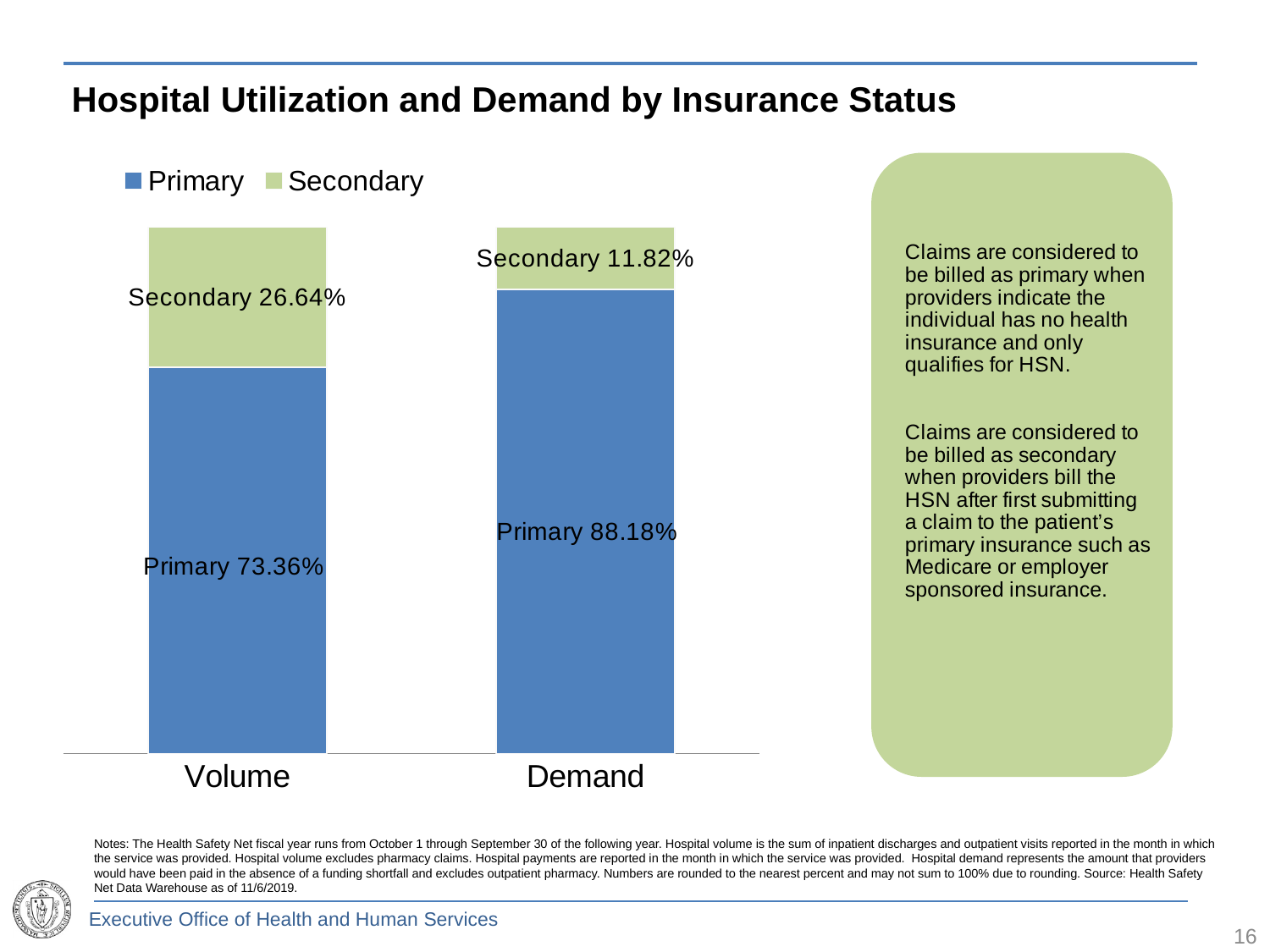
What is the Secondary share for Demand? 11.82% How many categories are shown on the x axis? 2 What is the difference between the Primary shares for Demand and Volume? 14.82% What is the difference between the Secondary shares for Volume and Demand? 14.82% What is the total of the stacked bar for Volume? 100% Which category has the lower Secondary share? Demand Which category has the higher Primary share, Volume or Demand? Demand What is the Primary share for Volume? 73.36% What kind of chart is shown on the slide? Stacked bar chart What is the Primary share for Demand? 88.18% What is the Secondary share for Volume? 26.64% How many series does the legend list? 2